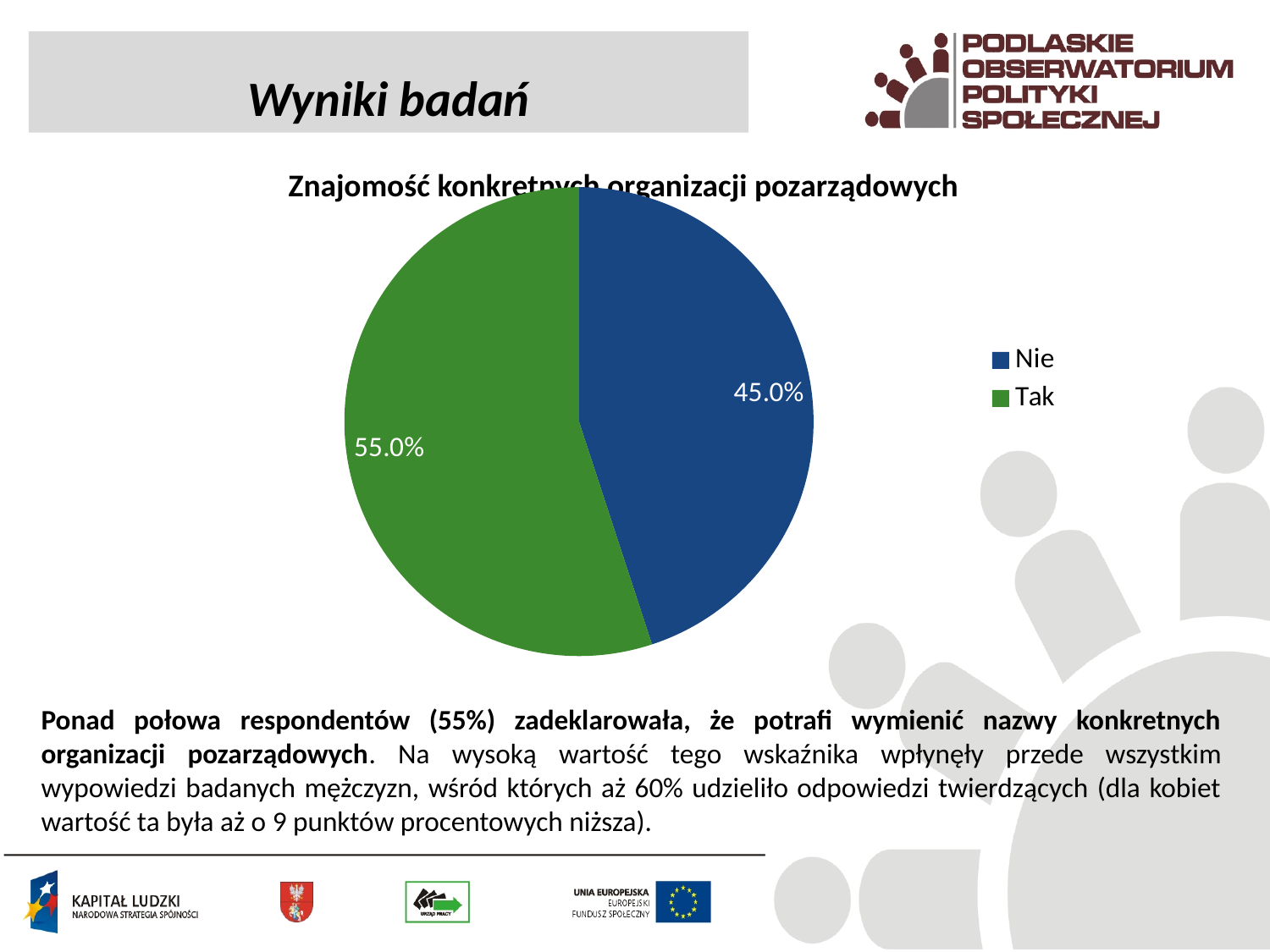
What kind of chart is shown on the slide? pie chart What share of the pie does the "Tak" slice represent? 55.0% Which is larger, the "Tak" slice or the "Nie" slice? Tak What is the title of the pie chart? Znajomość konkretnych organizacji pozarządowych What colour is the "Nie" slice in the pie chart? blue What is the value for "Nie" in the pie chart? 45.0% How many slices does the pie chart have? 2 What is the difference between the "Tak" and "Nie" slices? 10.0% How many entries does the legend list? 2 What is the value for "Tak" in the pie chart? 55.0% Which slice of the pie chart is the smallest? Nie Which slice of the pie chart is the largest? Tak